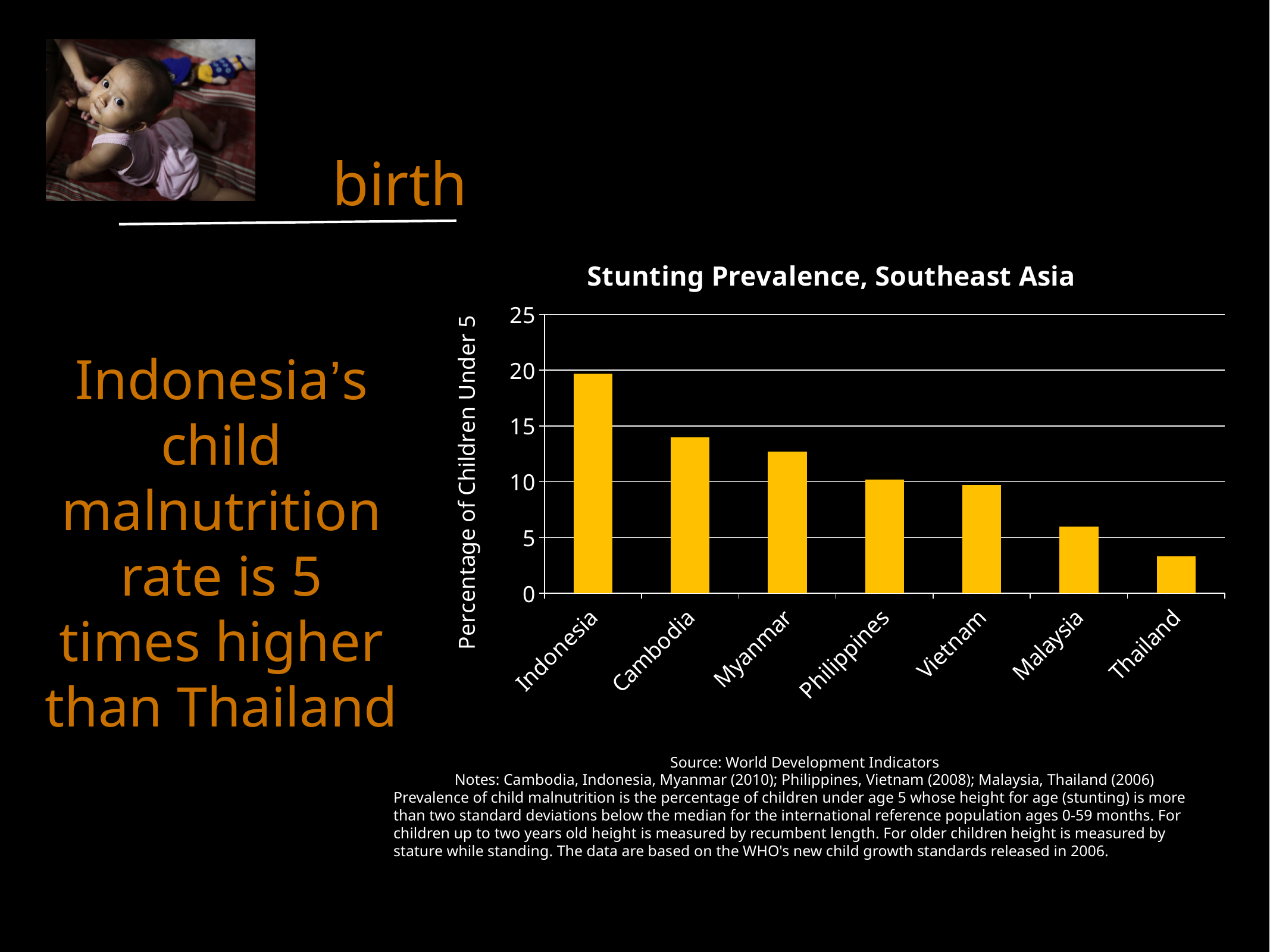
Which country has the highest stunting prevalence in the chart? Indonesia What type of chart is shown on the slide? bar chart Is the value for Thailand greater or less than 5? less Is the value for Myanmar greater or less than 10? greater Which country has the lowest stunting prevalence in the chart? Thailand What is the label on the vertical axis of the chart? Percentage of Children Under 5 How many countries are shown in the chart? 7 Do the bar values rise or fall from left to right across the chart? fall Is the value for Indonesia greater or less than 15? greater Which has a higher stunting prevalence, Cambodia or Myanmar? Cambodia What is the title of the chart? Stunting Prevalence, Southeast Asia